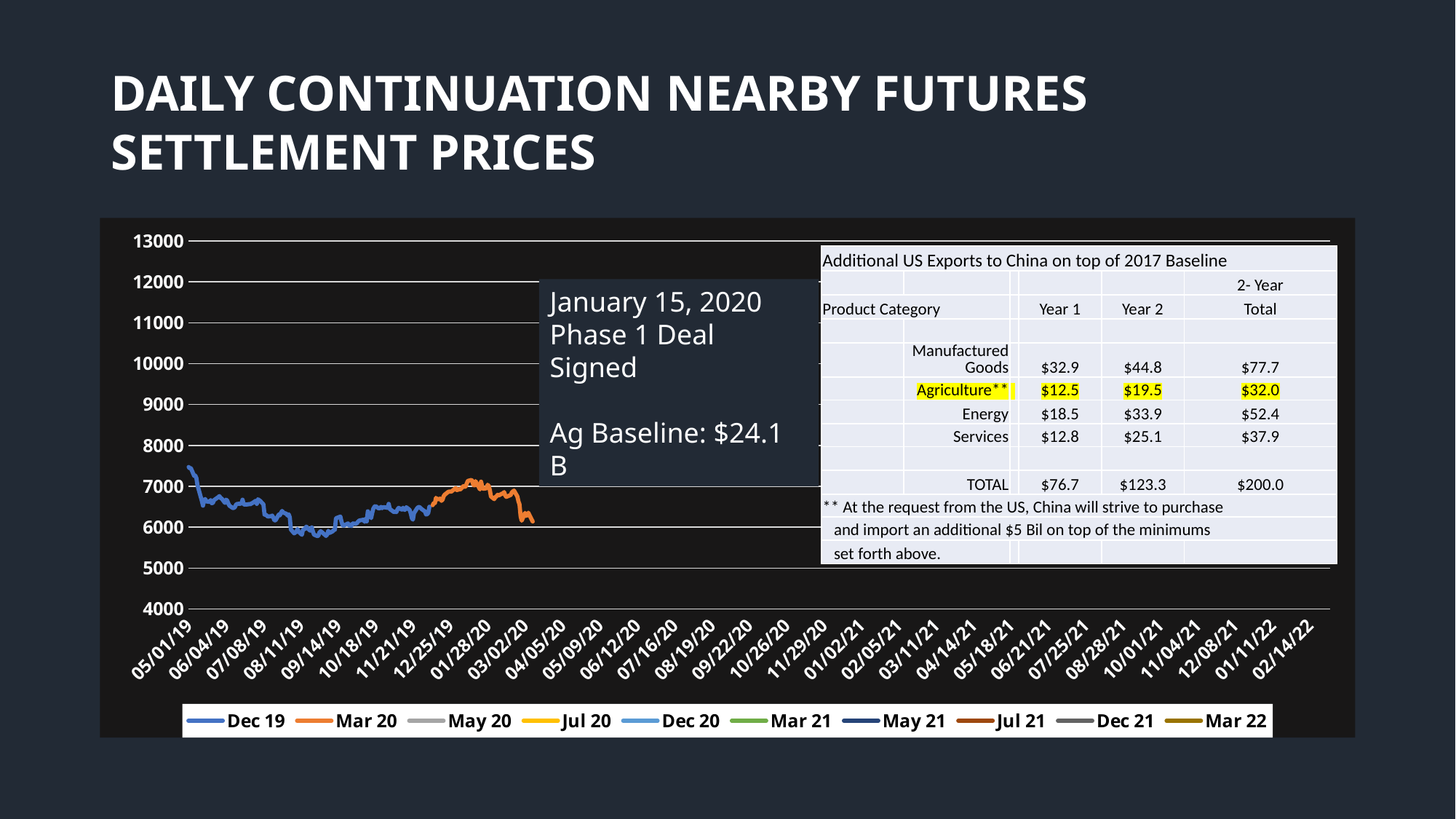
What is the lowest value shown on the chart's vertical axis? 4000 Which two series are actually plotted with visible lines on the chart? Dec 19 and Mar 20 Is the value of the Dec 19 series at 05/01/19 greater or less than 7000? greater How many series does the chart legend list? 10 Does the Dec 19 series rise or fall between 05/01/19 and 09/14/19? fall What kind of chart is shown on the slide? line chart Which is larger: the Dec 19 value at 05/01/19 or the Mar 20 value at 03/02/20? Dec 19 value at 05/01/19 Is the value of the Mar 20 series at 03/02/20 greater or less than 7000? less What is the highest value shown on the chart's vertical axis? 13000 Does the Mar 20 series rise or fall between 01/28/20 and 03/02/20? fall Is the value of the Dec 19 series at 08/11/19 greater or less than 7000? less